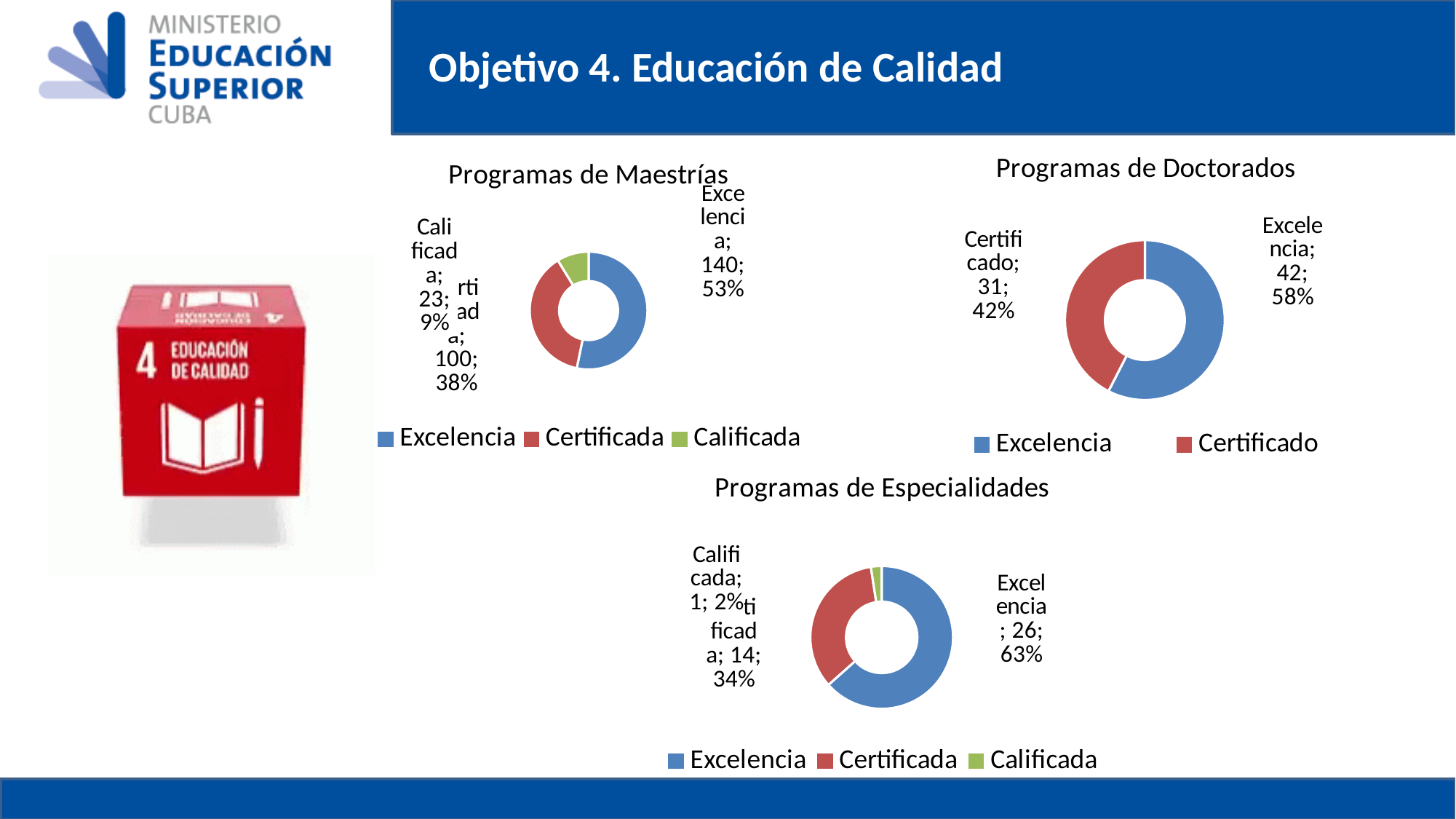
In the Programas de Especialidades chart, what is the value for Excelencia? 26 In the Programas de Doctorados chart, what is the value for Certificado? 31 What kind of chart is the Programas de Especialidades chart? Doughnut (pie) chart In the Programas de Especialidades chart, what is the total of all three categories? 41 In the Programas de Maestrías chart, how many programs are in the Excelencia category? 140 Which is larger in the Programas de Doctorados chart, Excelencia or Certificado? Excelencia In the Programas de Maestrías chart, what percentage share does Certificada have? 38% In the Programas de Maestrías chart, which category has the smallest value? Calificada How many series does the legend of the Programas de Doctorados chart list? 2 In the Programas de Maestrías chart, what is the difference between the Excelencia and Certificada values? 40 In the Programas de Especialidades chart, which category has the largest value? Excelencia In the Programas de Doctorados chart, what percentage share does Excelencia have? 58%